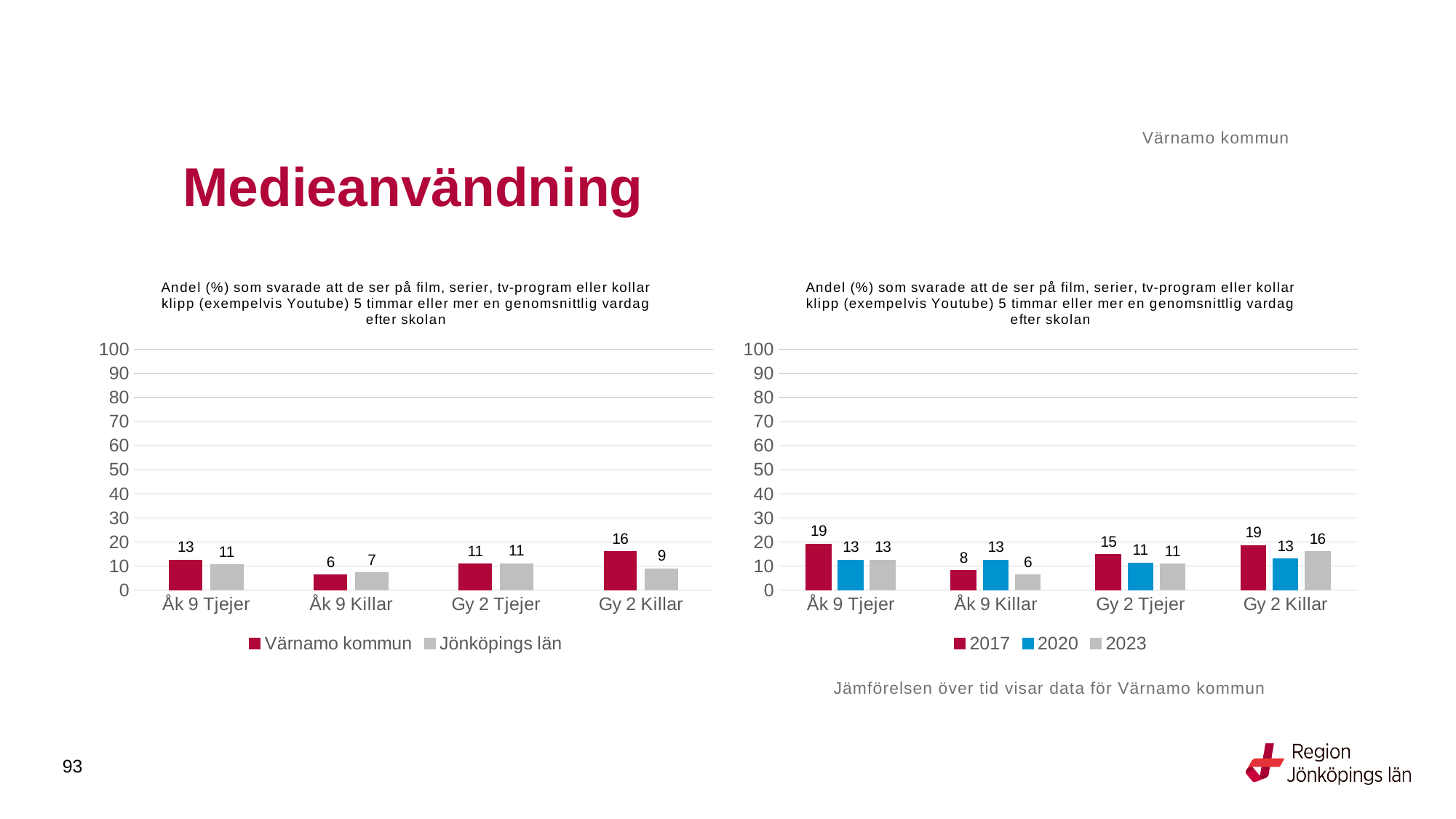
In the right chart, what is the difference between the 2017 and 2020 values for Åk 9 Tjejer? 6 In the left chart, which category has the lowest value for Jönköpings län? Åk 9 Killar In the right chart, which is larger for Gy 2 Killar: the 2020 value or the 2023 value? 2023 In the right chart, how many categories are shown on the x axis? 4 In the right chart, what is the value for 2017 for Åk 9 Tjejer? 19 In the left chart, what is the difference between Värnamo kommun and Jönköpings län for Gy 2 Killar? 7 What type of chart is the right chart? Bar chart In the left chart, what is the value for Värnamo kommun for Åk 9 Tjejer? 13 In the left chart, which category has the highest value for Värnamo kommun? Gy 2 Killar In the left chart, what is the value for Jönköpings län for Gy 2 Killar? 9 In the left chart, how many series does the legend list? 2 In the right chart, what is the value for 2023 for Åk 9 Killar? 6